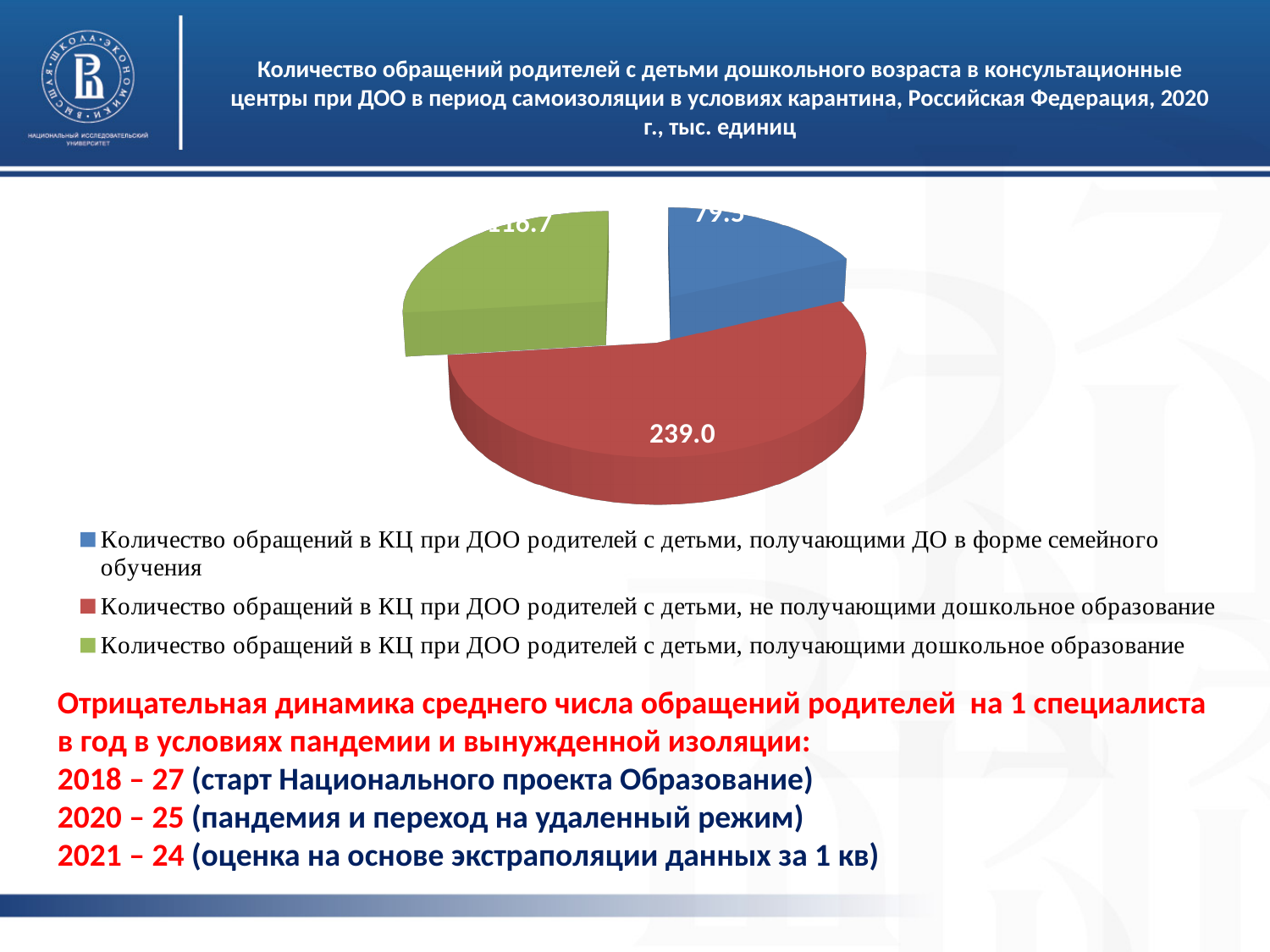
In what units are the values of the chart given, according to the title? тыс. единиц Which category has the largest slice of the pie? Количество обращений в КЦ при ДОО родителей с детьми, не получающими дошкольное образование How many slices does the pie chart have? 3 Which category has the smallest slice of the pie? Количество обращений в КЦ при ДОО родителей с детьми, получающими ДО в форме семейного обучения What is the value of the slice for 'Количество обращений в КЦ при ДОО родителей с детьми, не получающими дошкольное образование'? 239.0 Which slice is larger: the one for children not receiving preschool education (не получающими дошкольное образование) or the one for children receiving preschool education (получающими дошкольное образование)? не получающими дошкольное образование Which colour represents 'Количество обращений в КЦ при ДОО родителей с детьми, не получающими дошкольное образование' in the pie chart? red What kind of chart is shown on the slide? pie chart Which slice is larger: the one for children receiving preschool education (получающими дошкольное образование) or the one for children receiving preschool education in the form of family education (в форме семейного обучения)? получающими дошкольное образование How many entries does the legend list? 3